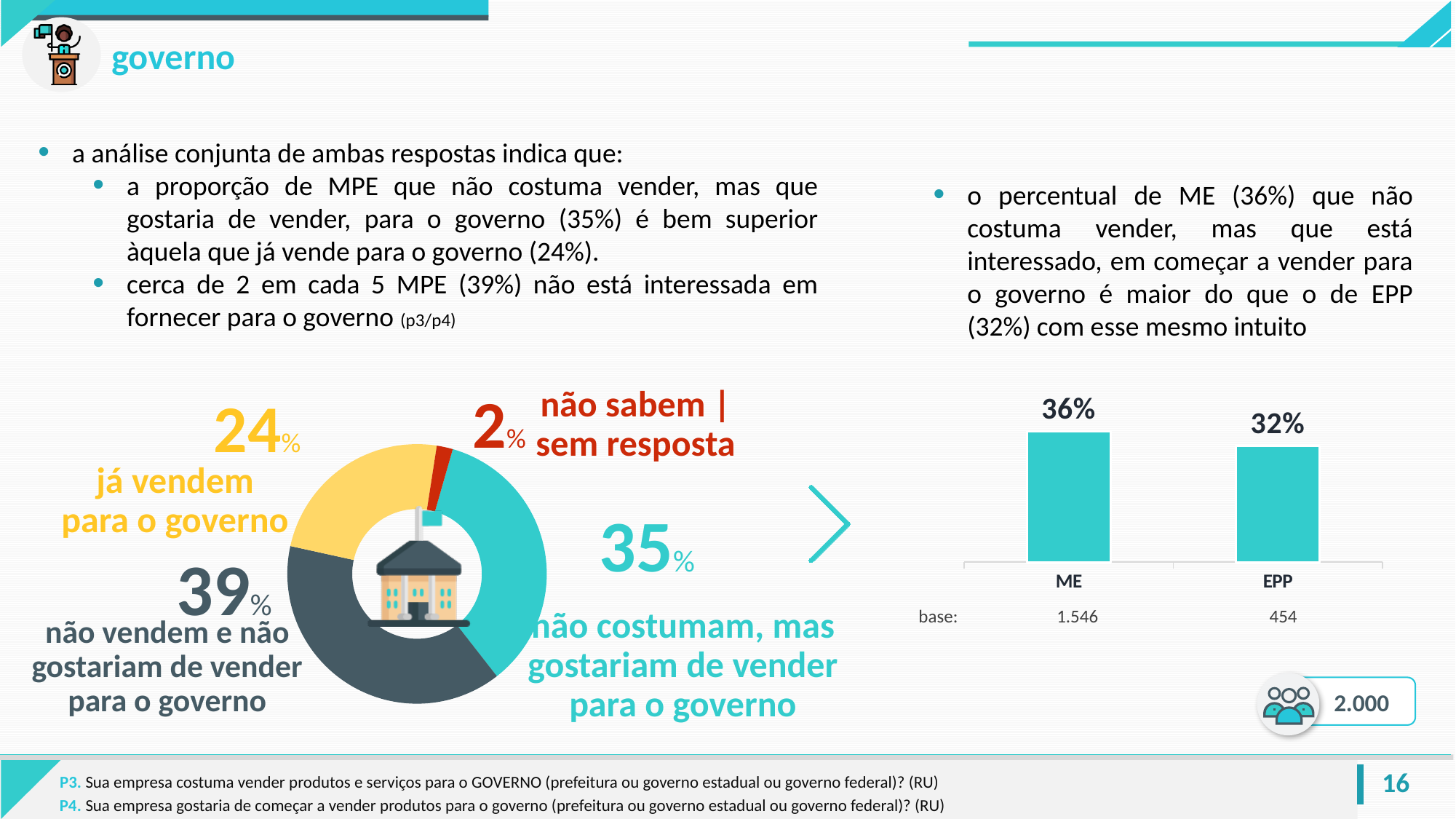
In the bar chart on the right, what is the value for EPP? 32% In the donut chart on the left, which category has the largest share? não vendem e não gostariam de vender para o governo In the bar chart on the right, what is the value for ME? 36% In the donut chart on the left, how many slices are there? 4 In the bar chart on the right, which is larger, ME or EPP? ME In the donut chart on the left, which category has the smallest share? não sabem | sem resposta In the donut chart on the left, what share of MPE do not usually sell but would like to sell to the government? 35% In the donut chart on the left, what share corresponds to 'não sabem | sem resposta'? 2% In the donut chart on the left, what share of MPE already sell to the government (já vendem para o governo)? 24% What type of chart is shown on the right side of the slide? bar chart In the donut chart on the left, what is the difference in percentage points between those who would like to sell to the government (35%) and those who already sell (24%)? 11 In the donut chart on the left, what share of MPE do not sell and would not like to sell to the government? 39%